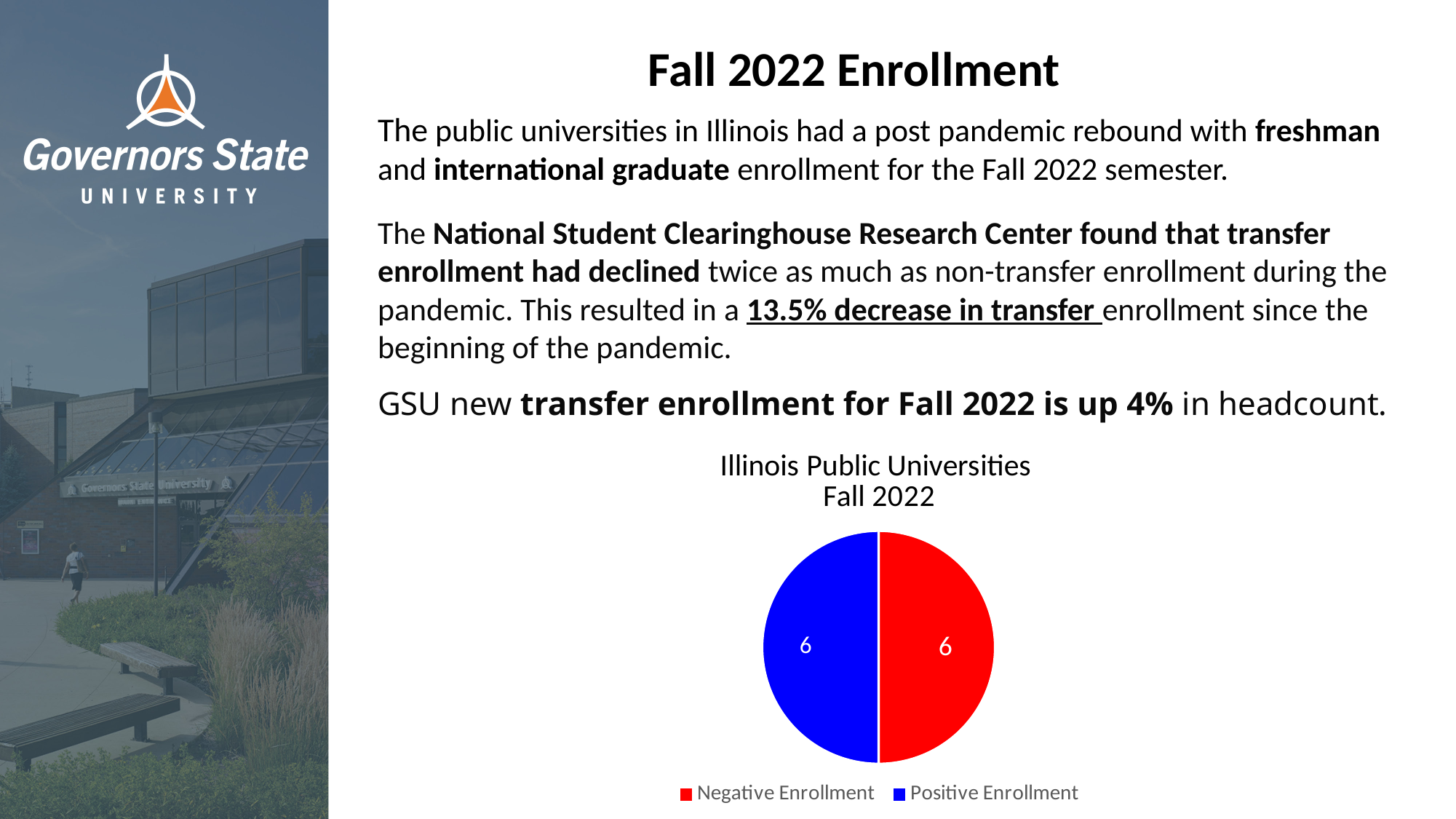
What is the total of the two slices in the pie chart? 12 What is the title of the chart? Illinois Public Universities Fall 2022 What is the difference between the Negative Enrollment and Positive Enrollment values? 0 Which colour represents Positive Enrollment in the pie chart? blue What share of the pie does Positive Enrollment represent? 50% What kind of chart is shown on the slide? pie chart What share of the pie does Negative Enrollment represent? 50% How many slices does the pie chart have? 2 How many entries does the legend list? 2 What is the value for Negative Enrollment? 6 What is the value for Positive Enrollment? 6